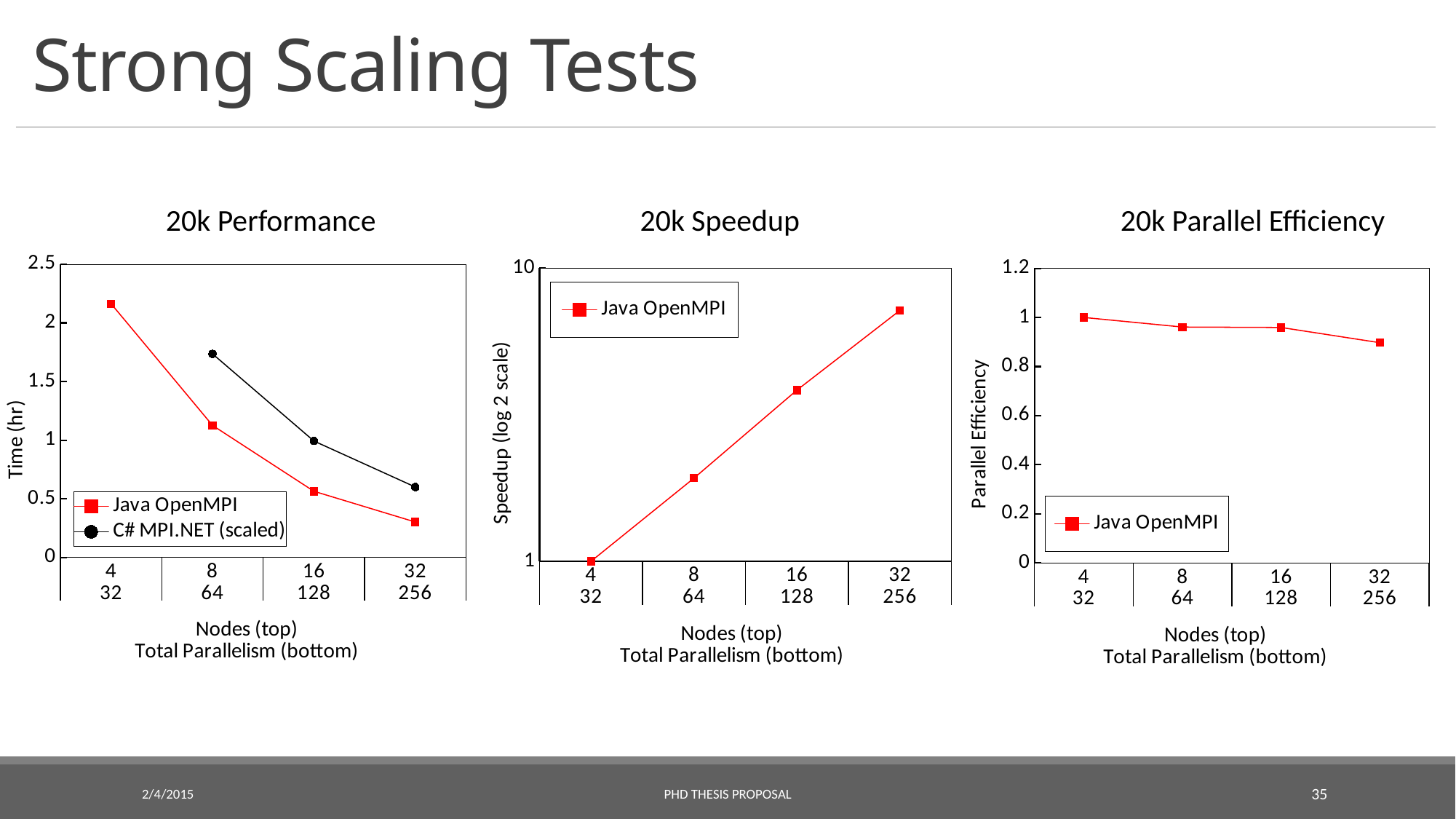
In the "20k Speedup" chart, what is the Java OpenMPI speedup at 4 nodes? 1 What kind of chart is the "20k Performance" chart? line chart In the "20k Performance" chart, is the Java OpenMPI time at 4 nodes greater or less than 2 hours? greater In the "20k Performance" chart, does the Java OpenMPI time rise or fall as the number of nodes increases? fall What is the y-axis label of the "20k Speedup" chart? Speedup (log 2 scale) How many series does the legend of the "20k Performance" chart list? 2 In the "20k Speedup" chart, does the speedup rise or fall as the number of nodes increases? rise In the "20k Parallel Efficiency" chart, what is the parallel efficiency at 4 nodes? 1 How many node counts are plotted on the x axis of the "20k Speedup" chart? 4 In the "20k Performance" chart, is the Java OpenMPI time at 32 nodes greater or less than 0.5 hours? less In the "20k Parallel Efficiency" chart, at which node count is the parallel efficiency lowest? 32 In the "20k Performance" chart, which series has the higher time at 8 nodes, Java OpenMPI or C# MPI.NET (scaled)? C# MPI.NET (scaled)